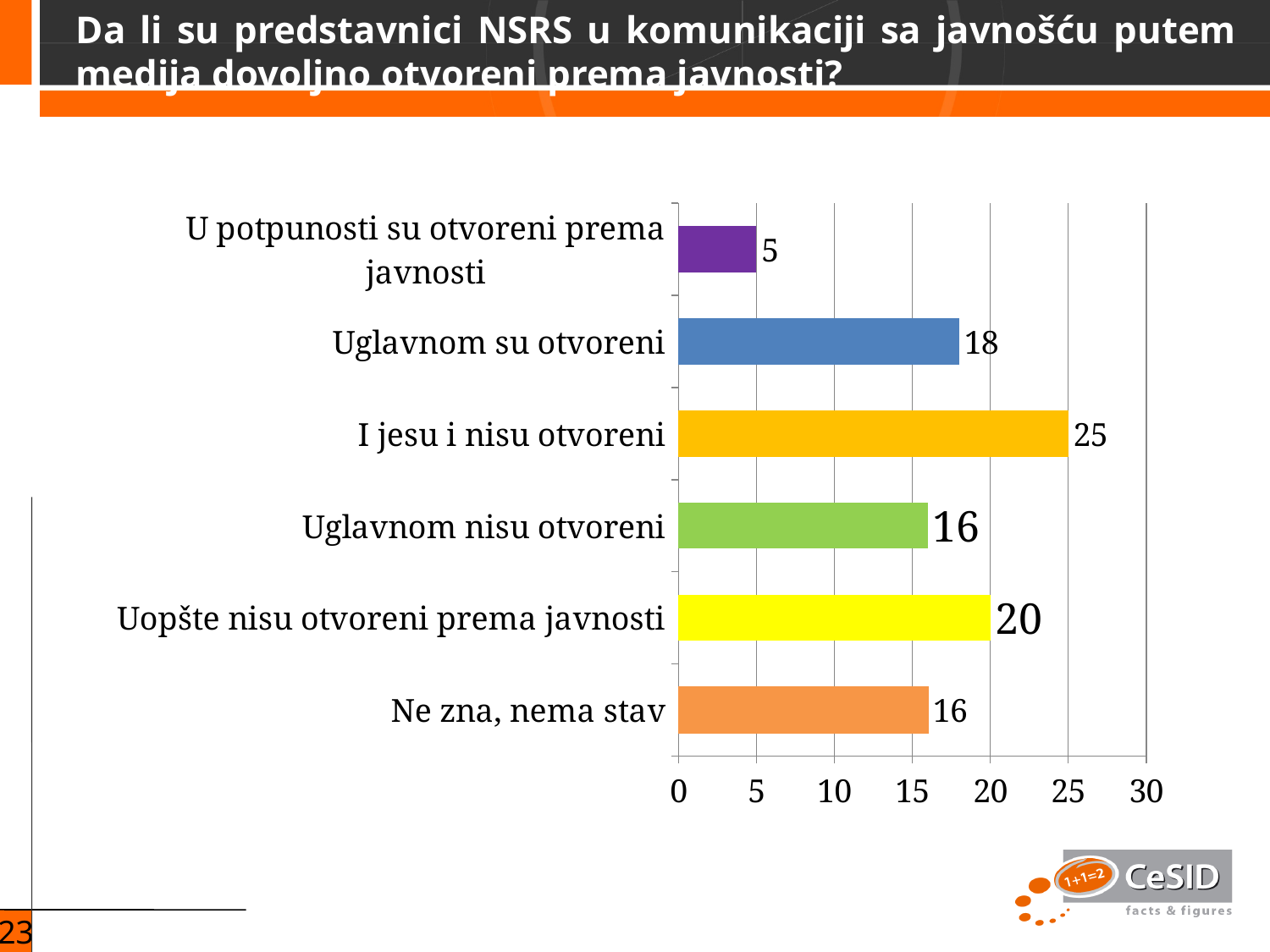
What is the value for "Uglavnom su otvoreni"? 18 Is the value for "Ne zna, nema stav" greater or less than 20? less Which category has the highest value? I jesu i nisu otvoreni What is the highest value shown on the horizontal axis? 30 Which is larger, the value for "Uopšte nisu otvoreni prema javnosti" or the value for "Uglavnom nisu otvoreni"? Uopšte nisu otvoreni prema javnosti What is the value for "I jesu i nisu otvoreni"? 25 Which category has the lowest value? U potpunosti su otvoreni prema javnosti What kind of chart is shown on the slide? bar chart What is the value for "Uopšte nisu otvoreni prema javnosti"? 20 How many categories are shown in the chart? 6 What is the difference between the values for "I jesu i nisu otvoreni" and "Uglavnom su otvoreni"? 7 What is the value for "U potpunosti su otvoreni prema javnosti"? 5